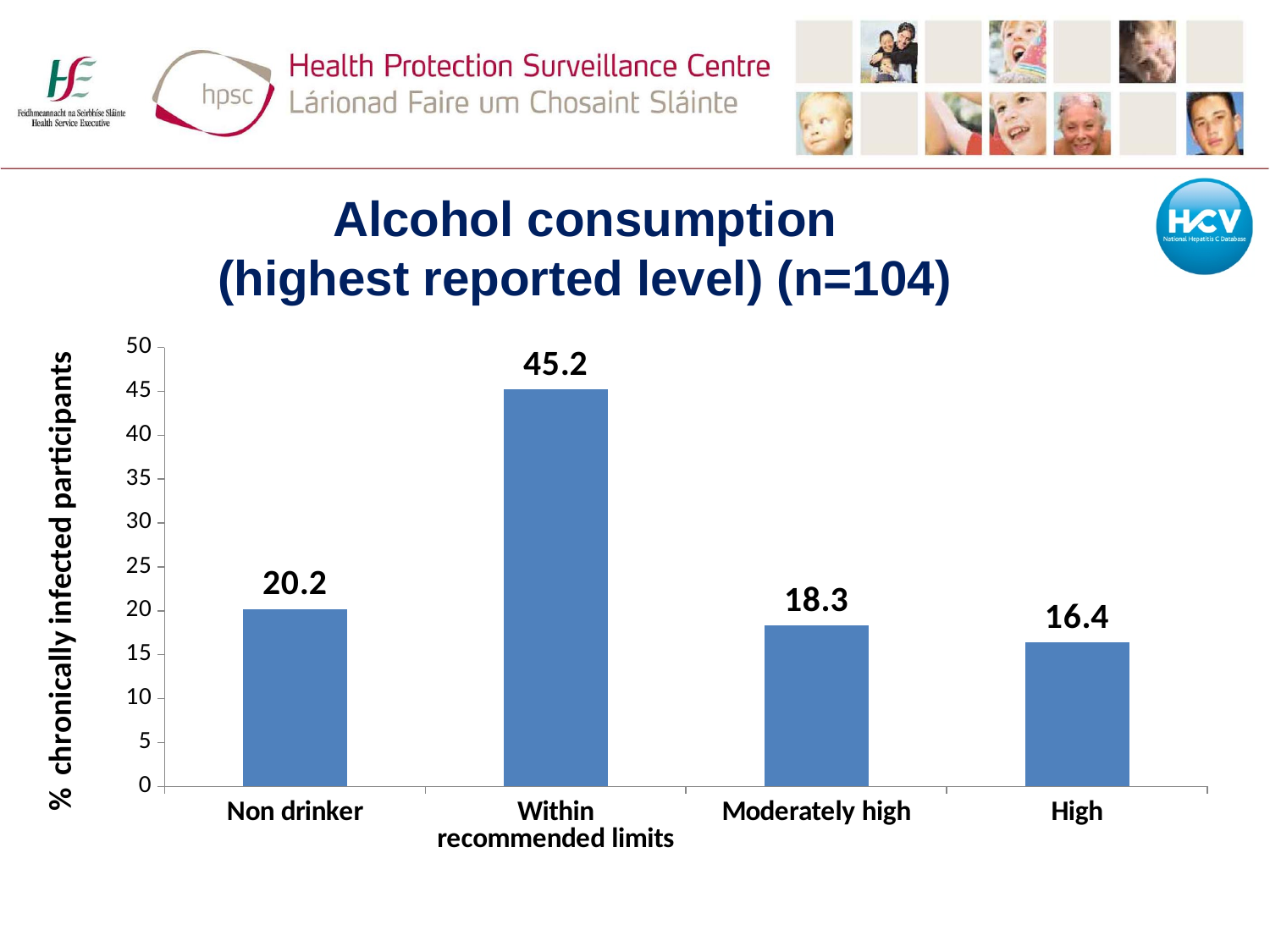
What is the difference between the values for Moderately high and High? 1.9 Which category has the lowest value? High What is the difference between the values for Within recommended limits and Non drinker? 25 How many categories are shown on the x axis? 4 What is the value for Moderately high? 18.3 What is the value for Within recommended limits? 45.2 What is the label of the y axis? % chronically infected participants What is the value for Non drinker? 20.2 Which is larger, the value for Non drinker or the value for Moderately high? Non drinker What is the value for High? 16.4 What kind of chart is shown on the slide? Bar chart Which category has the highest value? Within recommended limits